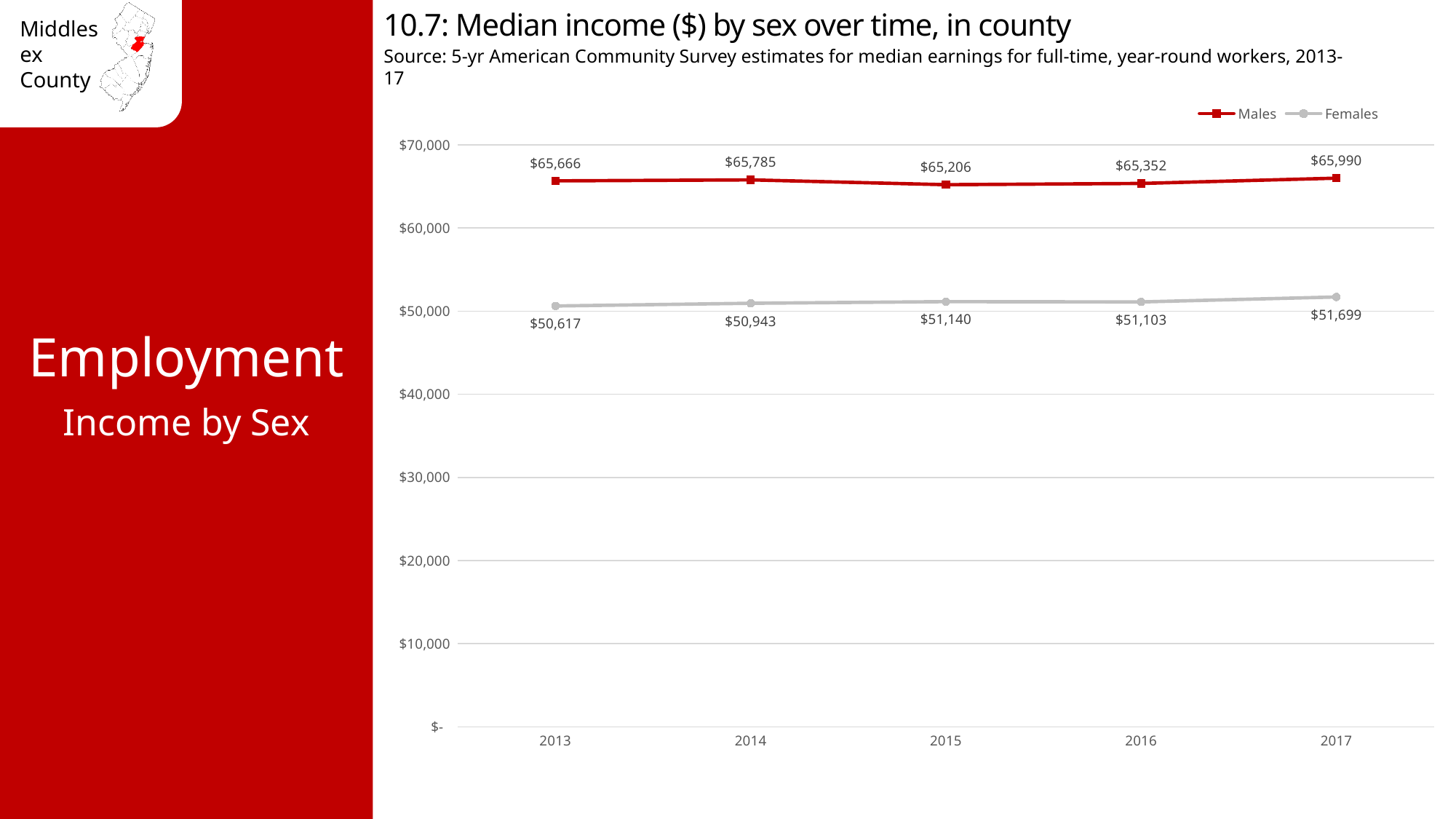
What was the median income for Females in 2013? $50,617 How many years are shown on the x axis? 5 What was the median income for Females in 2017? $51,699 Is the median income for Males in 2014 greater or less than $60,000? greater How many series does the legend list? 2 What is the difference between the Males and Females median income in 2017? $14,291 Which was larger, the Females median income in 2015 or in 2016? 2015 In which year was the median income for Females lowest? 2013 What was the median income for Males in 2015? $65,206 In which year was the median income for Males highest? 2017 What kind of chart is shown on the slide? line chart Which series is drawn in red? Males